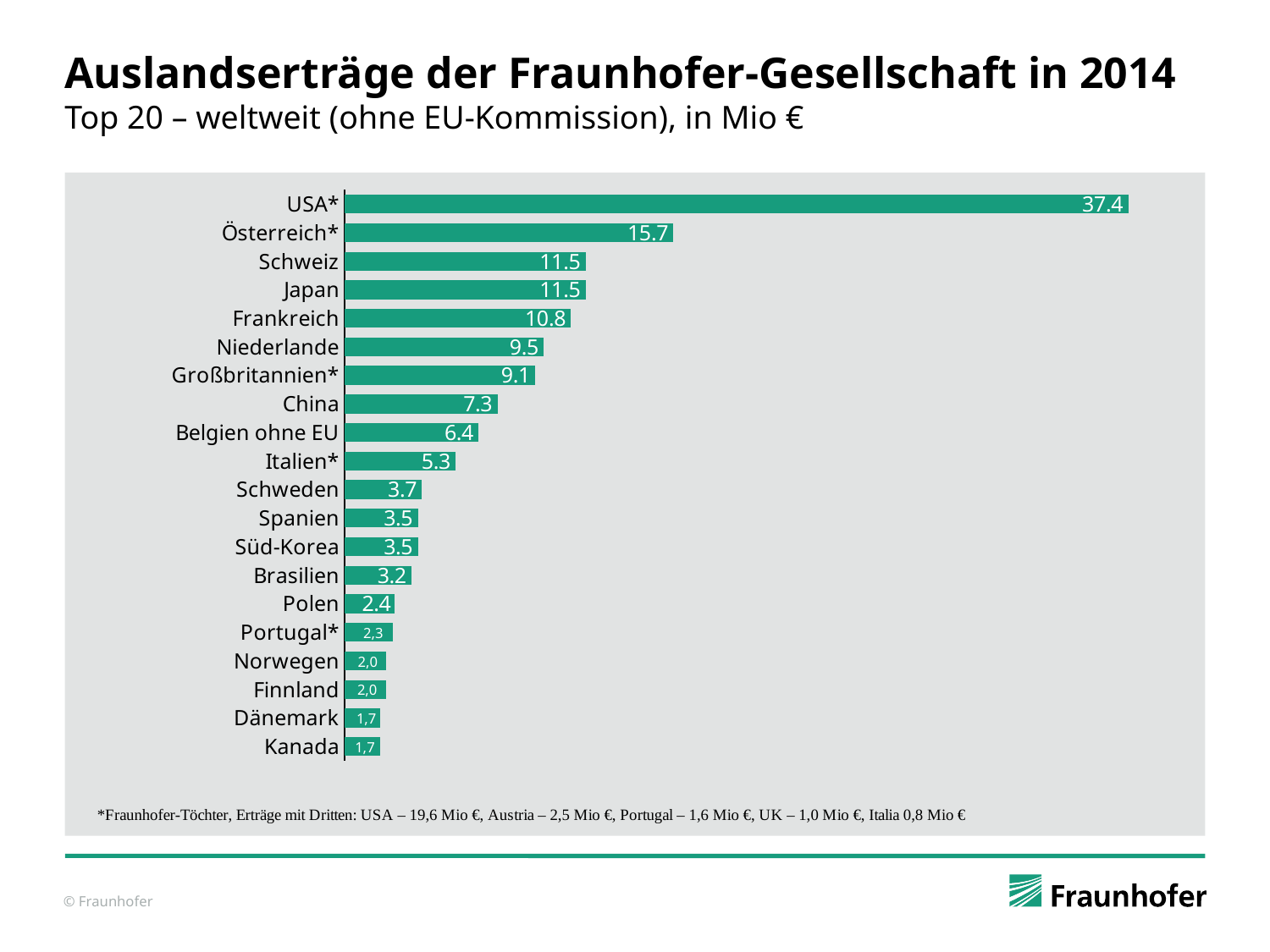
What is the value shown for Frankreich? 10.8 Which has a larger value, Schweden or Brasilien? Schweden What kind of chart is shown on the slide? Bar chart Which country has the highest value in the chart? USA* What is the value shown for Belgien ohne EU? 6.4 Which has a larger value, China or Italien*? China What is the difference between the values for USA* and Österreich*? 21.7 What is the value for USA* in the chart? 37.4 What is the title of the slide? Auslandserträge der Fraunhofer-Gesellschaft in 2014 What is the difference between the values for Frankreich and Niederlande? 1.3 What is the value shown for Portugal*? 2,3 How many countries are shown in the chart? 20